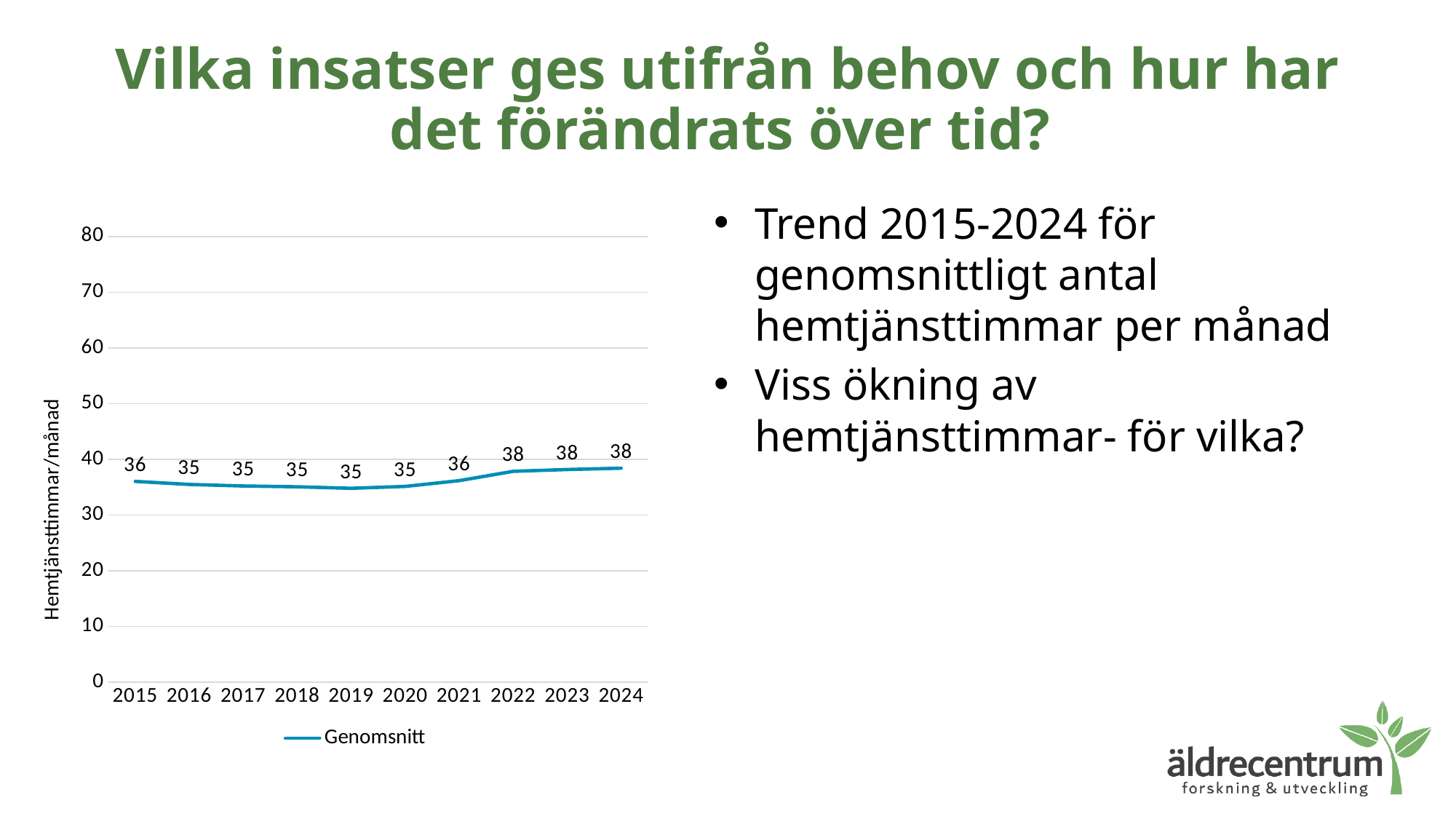
What kind of chart is shown on the slide? line chart What is the label on the y axis? Hemtjänsttimmar/månad What is the value for 2015? 36 What is the difference between the values for 2024 and 2015? 2 What is the value for 2024? 38 What is the lowest value plotted on the chart? 35 What is the value for 2021? 36 What is the value for 2019? 35 What is the highest value plotted on the chart? 38 How many series does the legend list? 1 How many years are plotted on the x axis? 10 Which is larger, the value for 2022 or the value for 2020? 2022